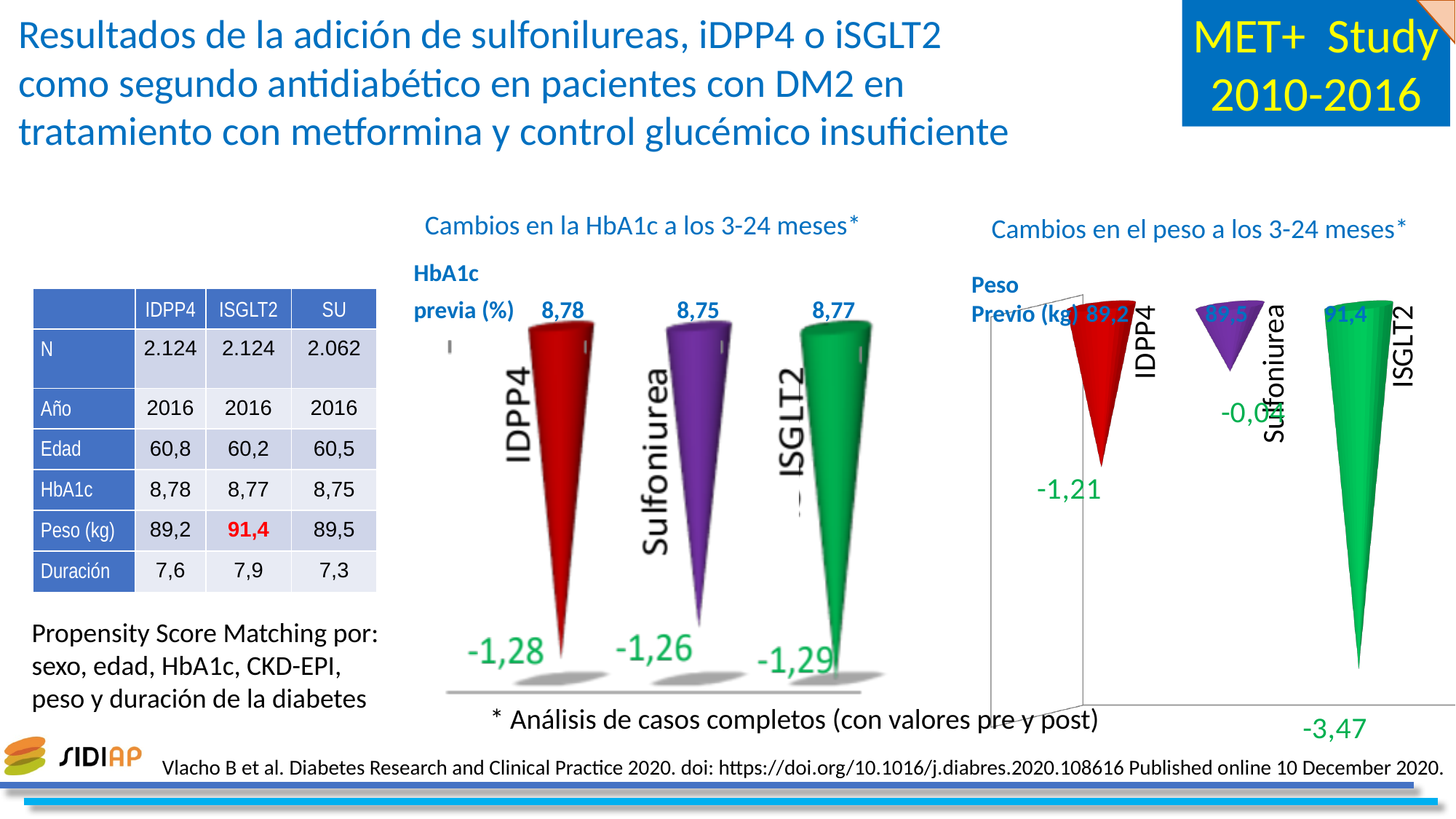
In the chart 'Cambios en la HbA1c a los 3-24 meses', what is the value shown for Sulfonilurea? -1,26 How many categories are plotted in the chart 'Cambios en la HbA1c a los 3-24 meses'? 3 In the chart 'Cambios en la HbA1c a los 3-24 meses', what is the value shown for ISGLT2? -1,29 In the chart 'Cambios en el peso a los 3-24 meses', which category shows the smallest weight decrease? Sulfonilurea What kind of chart is 'Cambios en el peso a los 3-24 meses'? bar chart In the chart 'Cambios en el peso a los 3-24 meses', what is the value shown for ISGLT2? -3,47 In the chart 'Cambios en la HbA1c a los 3-24 meses', what is the value shown for IDPP4? -1,28 In the chart 'Cambios en el peso a los 3-24 meses', which category shows the largest weight decrease? ISGLT2 In the chart 'Cambios en el peso a los 3-24 meses', which shows a larger weight decrease, IDPP4 or ISGLT2? ISGLT2 In the chart 'Cambios en el peso a los 3-24 meses', what is the difference between the values for ISGLT2 and IDPP4? 2,26 In the chart 'Cambios en la HbA1c a los 3-24 meses', what is the 'HbA1c previa (%)' value printed above the IDPP4 bar? 8,78 In the chart 'Cambios en el peso a los 3-24 meses', what is the value shown for IDPP4? -1,21